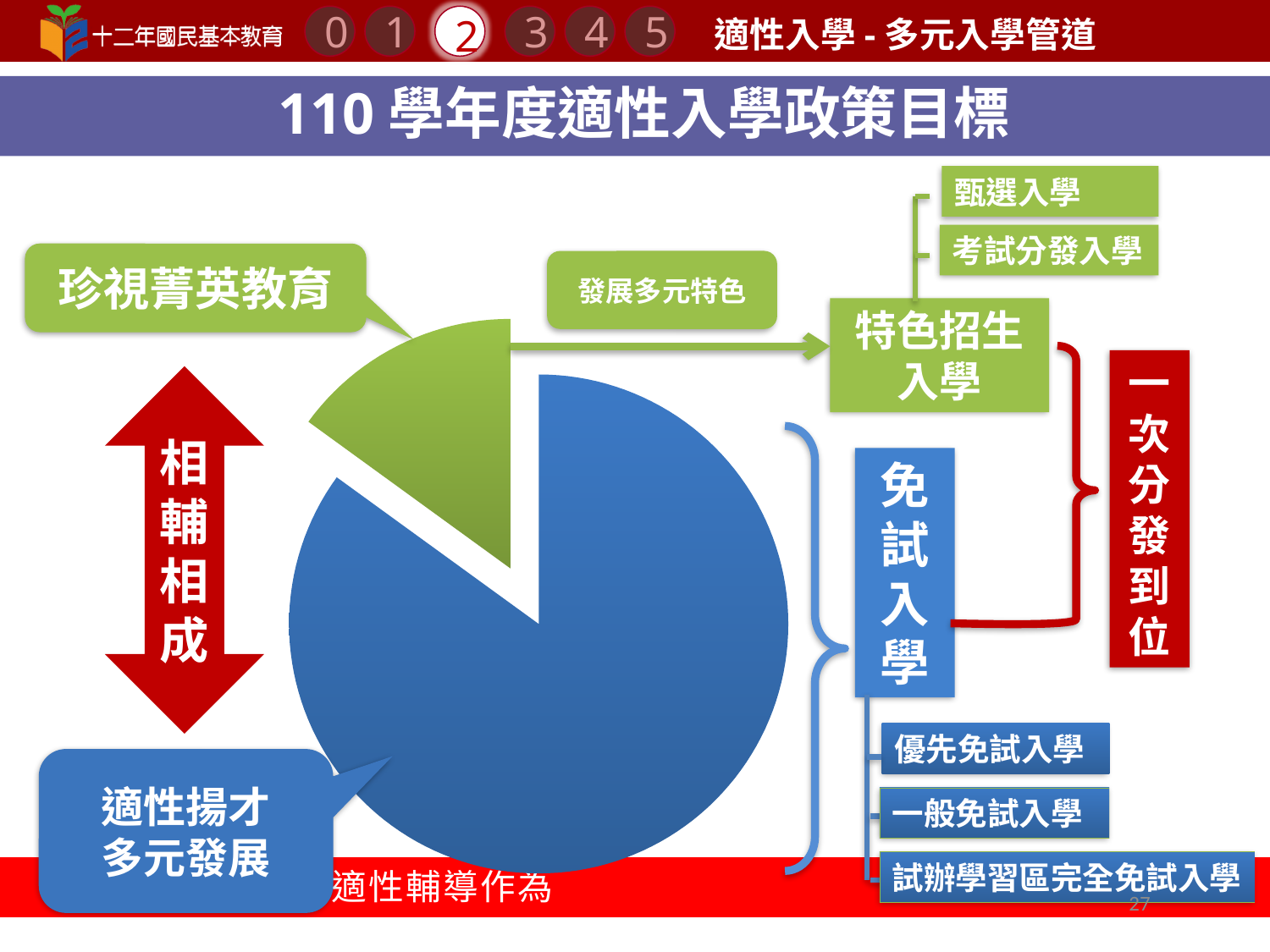
Which slice of the pie chart is larger, 免試入學 or 特色招生入學? 免試入學 Is the 免試入學 slice more or less than half of the pie chart? more What kind of chart is shown on the slide? pie chart What colour is the 免試入學 slice of the pie chart? blue What colour is the 特色招生入學 slice of the pie chart? green Which category takes up the smallest share of the pie chart? 特色招生入學 Which category takes up the largest share of the pie chart? 免試入學 How many slices does the pie chart have? 2